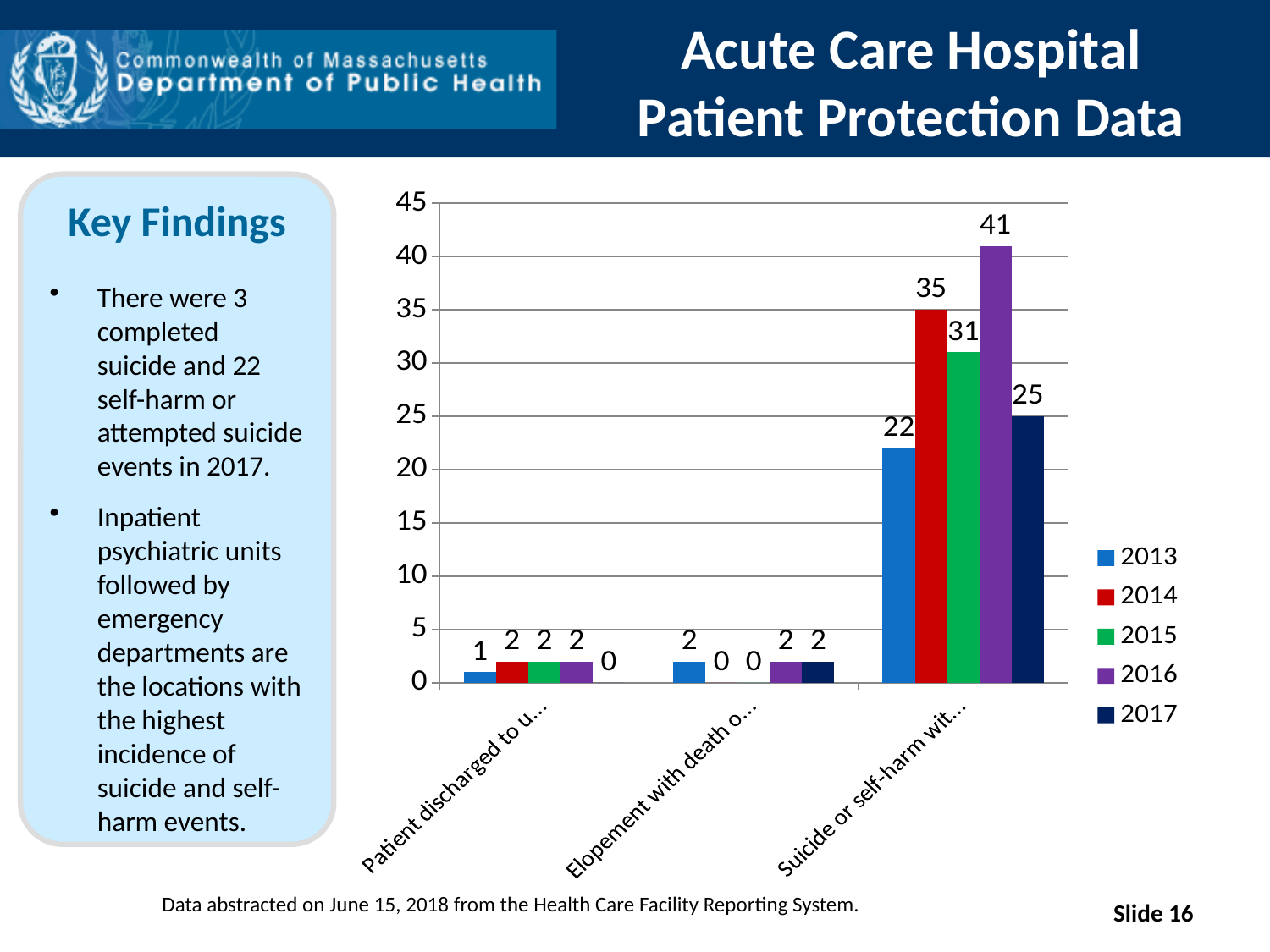
What is the value for 2013 in the 'Suicide or self-harm' category? 22 What kind of chart is shown on the slide? Bar chart What is the value for 2016 in the 'Suicide or self-harm' category? 41 Which year has the highest value in the 'Suicide or self-harm' category? 2016 What is the value for 2017 in the 'Patient discharged' category? 0 Which year has the lowest value in the 'Suicide or self-harm' category? 2013 What is the value for 2014 in the 'Elopement with death' category? 0 How many series does the legend list? 5 How many categories are shown on the x axis? 3 What is the difference between the 2016 and 2017 values in the 'Suicide or self-harm' category? 16 Is the value for 2014 in the 'Suicide or self-harm' category greater or less than 30? greater In the 'Suicide or self-harm' category, which is larger: the value for 2014 or the value for 2015? 2014